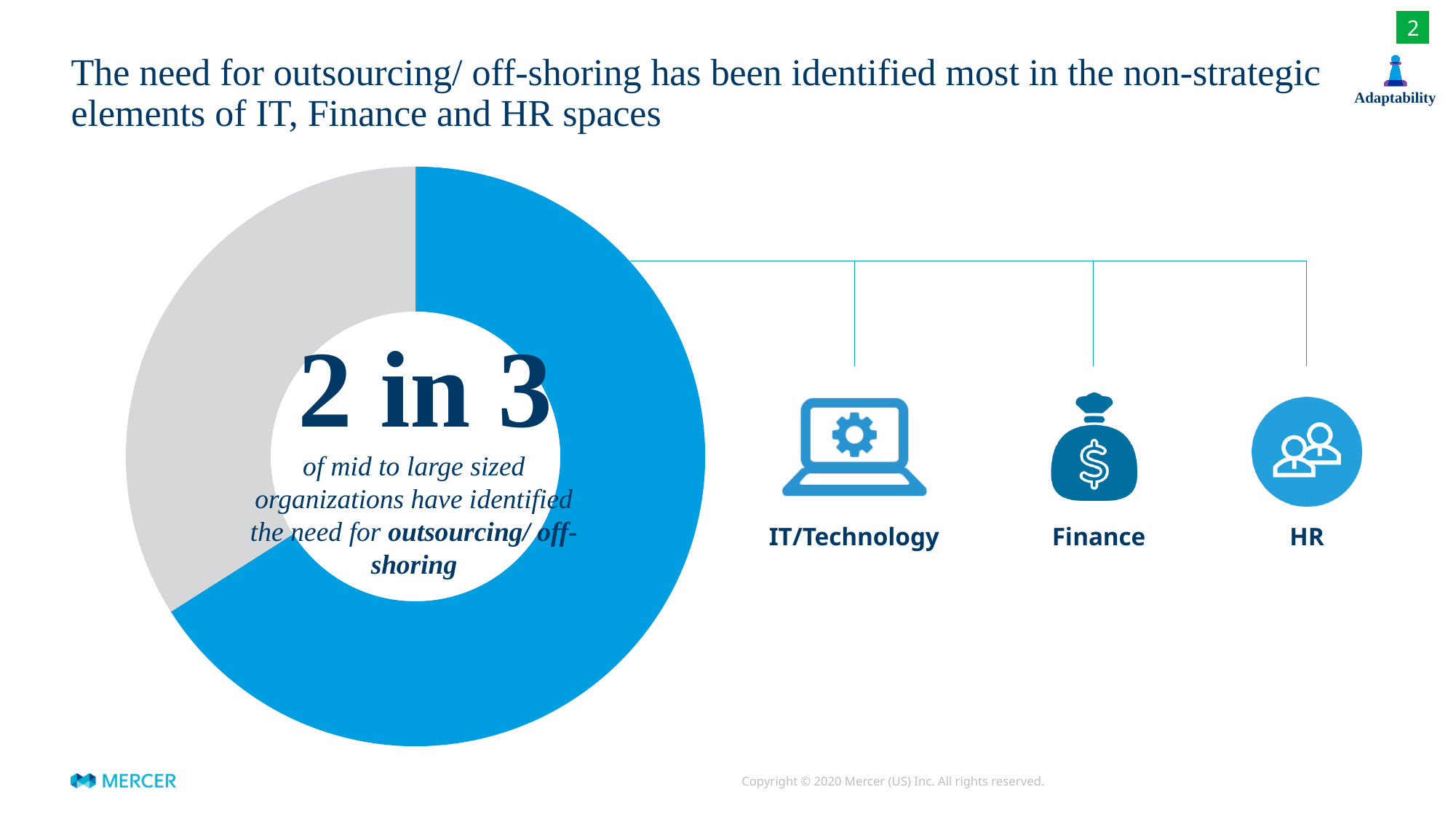
Is the blue segment of the donut chart greater or less than half of the ring? greater Which three areas are listed to the right of the donut chart? IT/Technology, Finance, HR According to the donut chart, what proportion of mid to large sized organizations have identified the need for outsourcing/ off-shoring? 2 in 3 What colour is the segment of the donut chart representing organizations that have identified the need for outsourcing/ off-shoring? Blue How many segments does the donut chart have? 2 What kind of chart is shown on the left of the slide? Donut chart In the donut chart, which segment is larger, the blue one or the grey one? The blue one What statistic is printed in the centre of the donut chart? 2 in 3 How many functional areas are listed to the right of the donut chart? 3